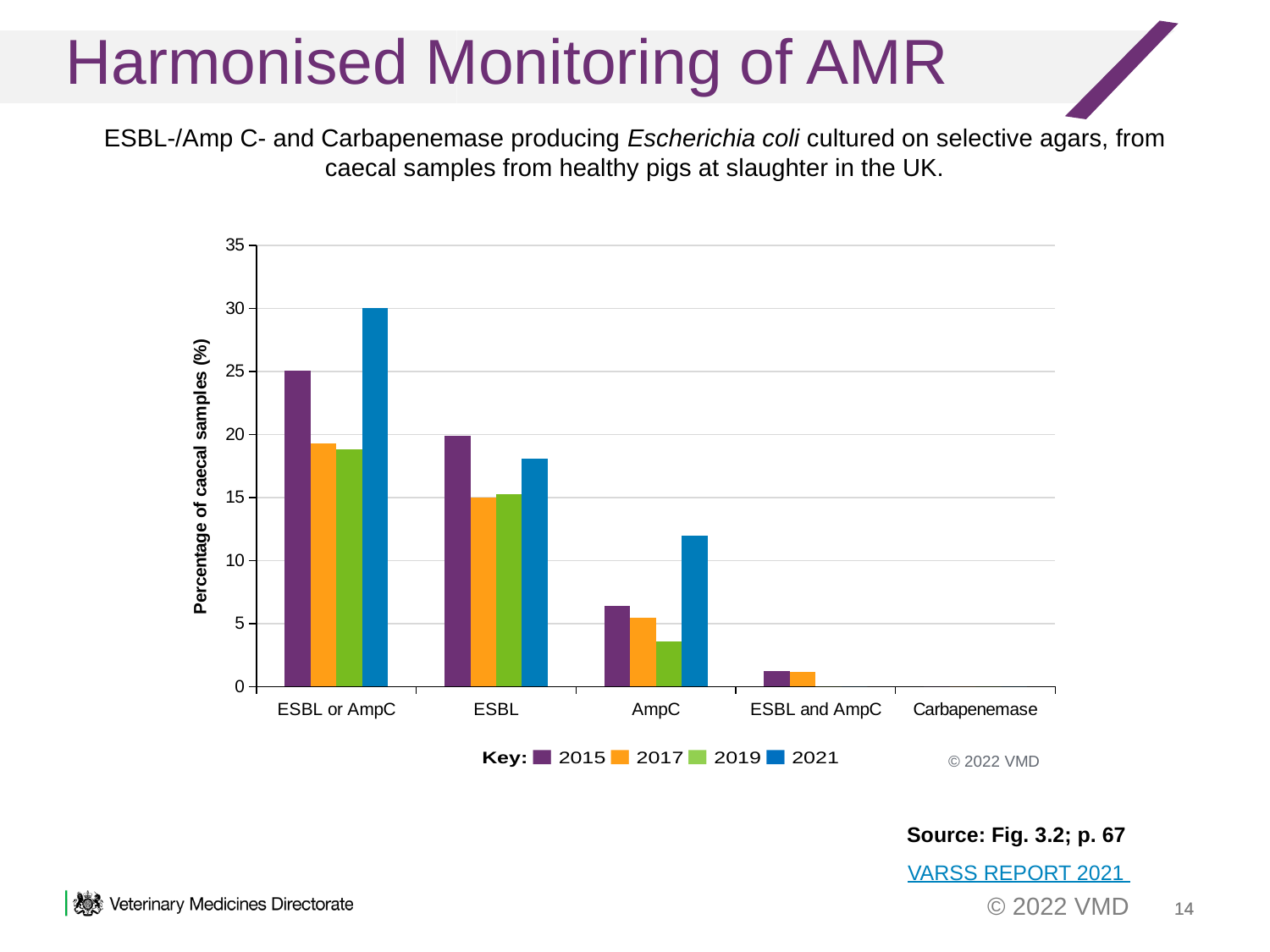
How many series does the key list? 4 What is the label of the y axis? Percentage of caecal samples (%) Which is larger, the 2015 value for ESBL or the 2021 value for ESBL? 2015 Which category has the highest values overall? ESBL or AmpC Is the value for ESBL or AmpC in 2021 greater or less than 25? greater Which year has the highest value for ESBL or AmpC? 2021 How many categories are shown on the x axis? 5 What kind of chart is shown on the slide? bar chart Which is larger, the 2015 value for AmpC or the 2021 value for AmpC? 2021 Is the value for AmpC in 2021 greater or less than 10? greater Which year has the lowest value for AmpC? 2019 Is the value for ESBL in 2017 greater or less than 20? less